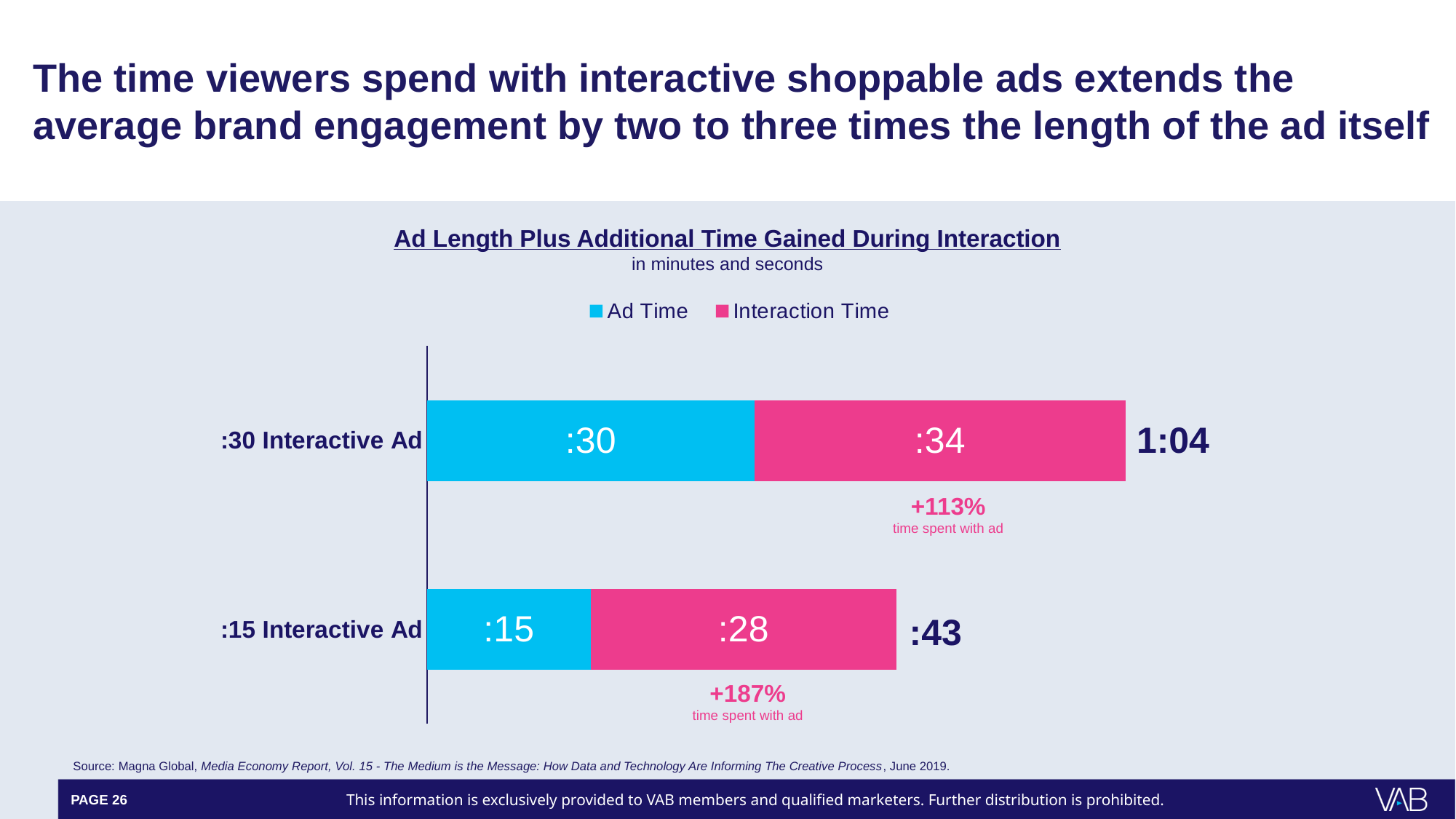
What kind of chart is shown on the slide? Stacked bar chart How many series does the legend list? 2 What percentage increase in time spent with ad is shown for the :15 Interactive Ad? +187% What is the difference in Interaction Time between the :30 Interactive Ad and the :15 Interactive Ad, in seconds? 6 seconds What is the Interaction Time value for the :15 Interactive Ad? :28 What is the total time shown for the :15 Interactive Ad bar? :43 What is the Ad Time value for the :30 Interactive Ad? :30 Which category has the lowest Ad Time? :15 Interactive Ad What is the total time shown for the :30 Interactive Ad bar? 1:04 What is the Interaction Time value for the :30 Interactive Ad? :34 How many categories are shown in the chart? 2 Which ad has the higher Interaction Time, the :30 Interactive Ad or the :15 Interactive Ad? :30 Interactive Ad